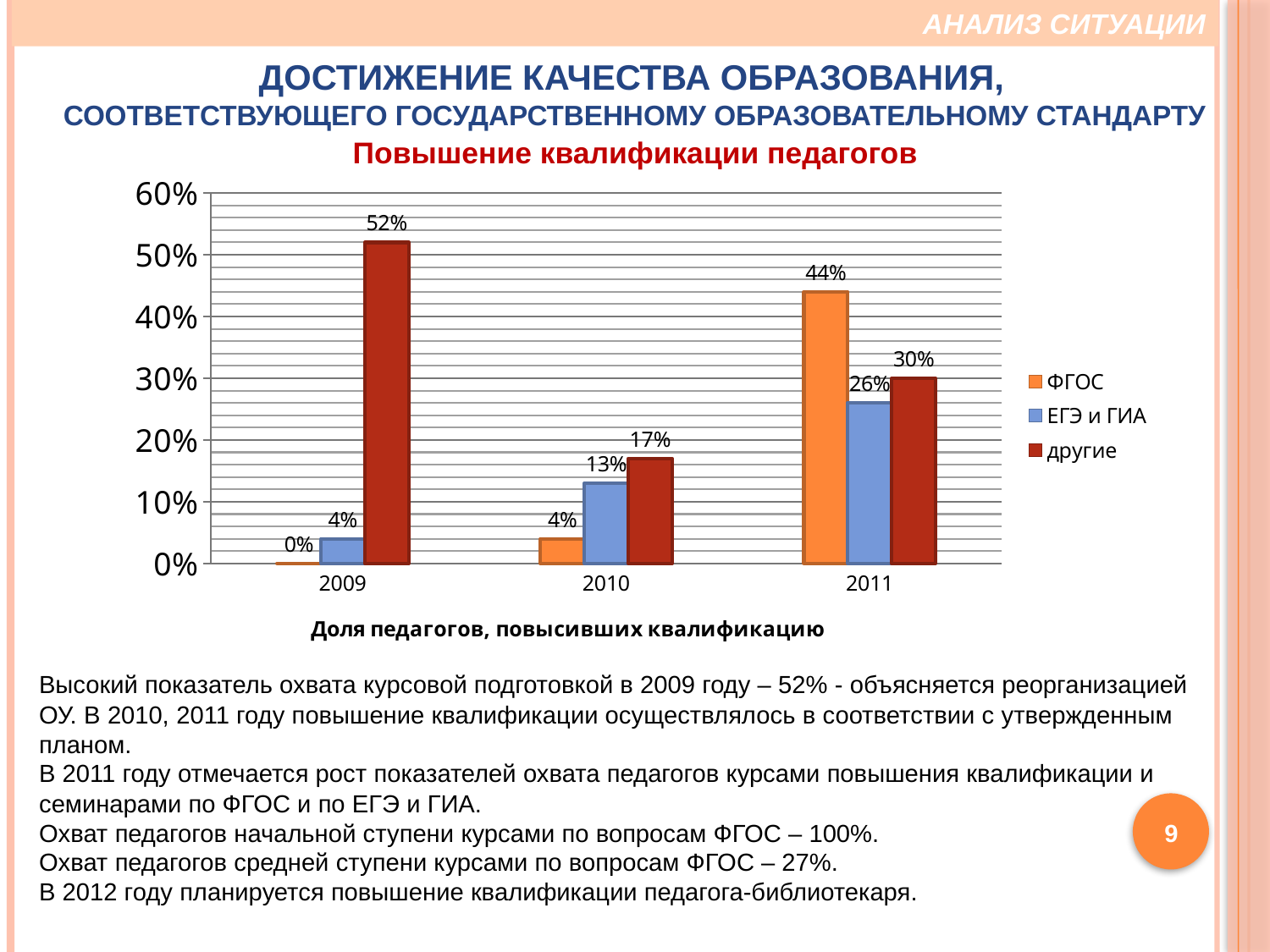
What is the value for ФГОС in 2011? 44% In which year is the value for другие lowest? 2010 What is the difference between the другие value in 2009 and the другие value in 2011? 22% What is the value for другие in 2009? 52% What is the value for ЕГЭ и ГИА in 2010? 13% Which is larger in 2011: the value for ЕГЭ и ГИА or the value for другие? другие What is the value for ФГОС in 2009? 0% What kind of chart is shown on the slide? Bar chart How many series does the legend list? 3 How many years are shown on the x axis? 3 Do the values for ЕГЭ и ГИА rise or fall from 2009 to 2011? Rise In which year is the value for ФГОС highest? 2011